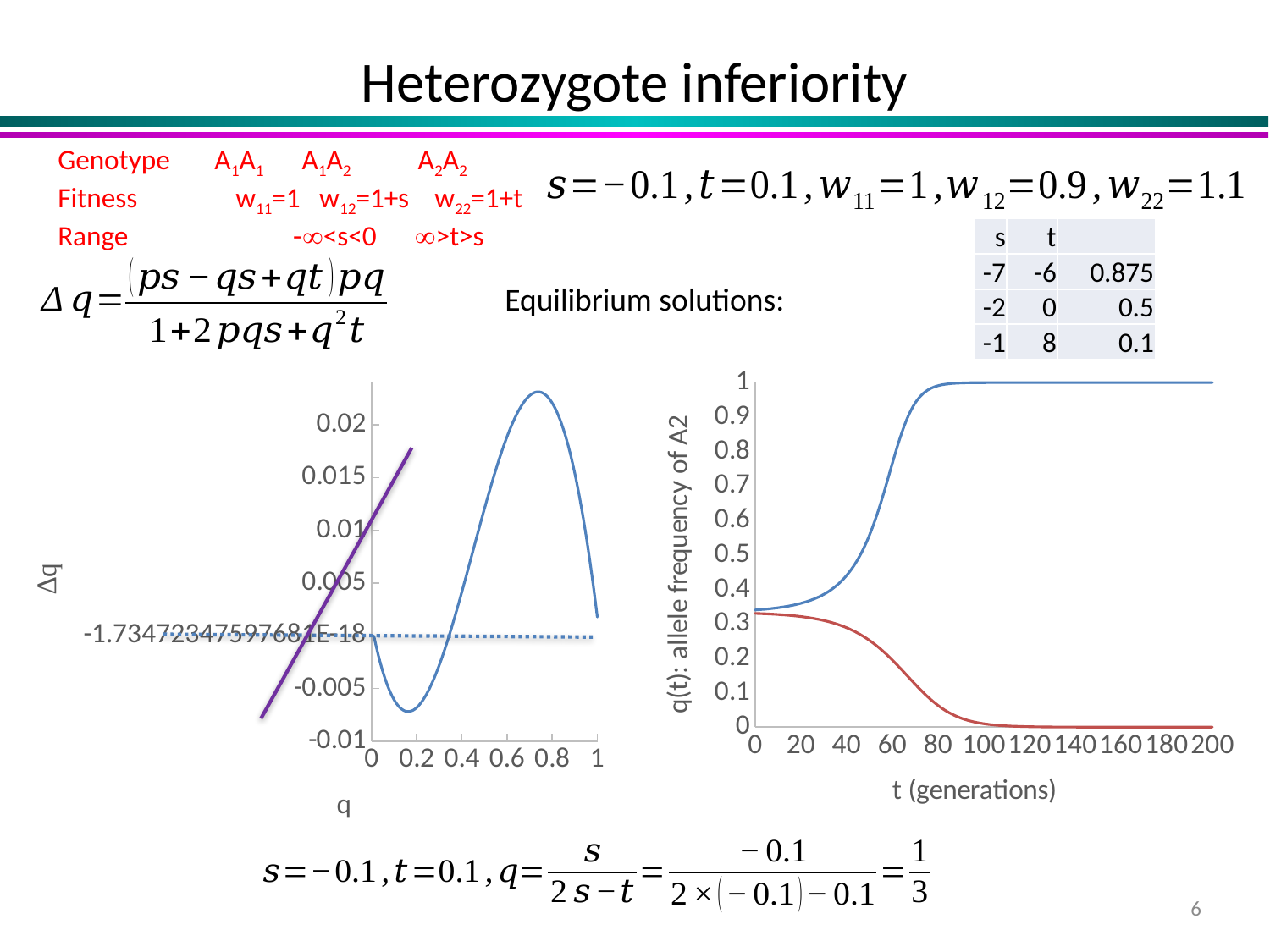
In the right-hand chart, how many curves are plotted? 2 In the right-hand chart, what is the title of the y axis? q(t): allele frequency of A2 In the right-hand chart, is the value of the blue curve at t = 200 greater or less than 0.5? greater In the right-hand chart, does the red curve rise or fall as t increases from 0 to 200? fall In the right-hand chart, is the value of the blue curve at t = 0 greater or less than 0.5? less What kind of chart is the right-hand chart with the x axis labelled t (generations)? line chart What kind of chart is the left-hand chart with the x axis labelled q? line chart In the right-hand chart, does the blue curve rise or fall as t increases from 0 to 200? rise In the left-hand chart, is the value of the blue curve at q = 0.8 greater or less than 0.01? greater In the right-hand chart, what is the title of the x axis? t (generations)